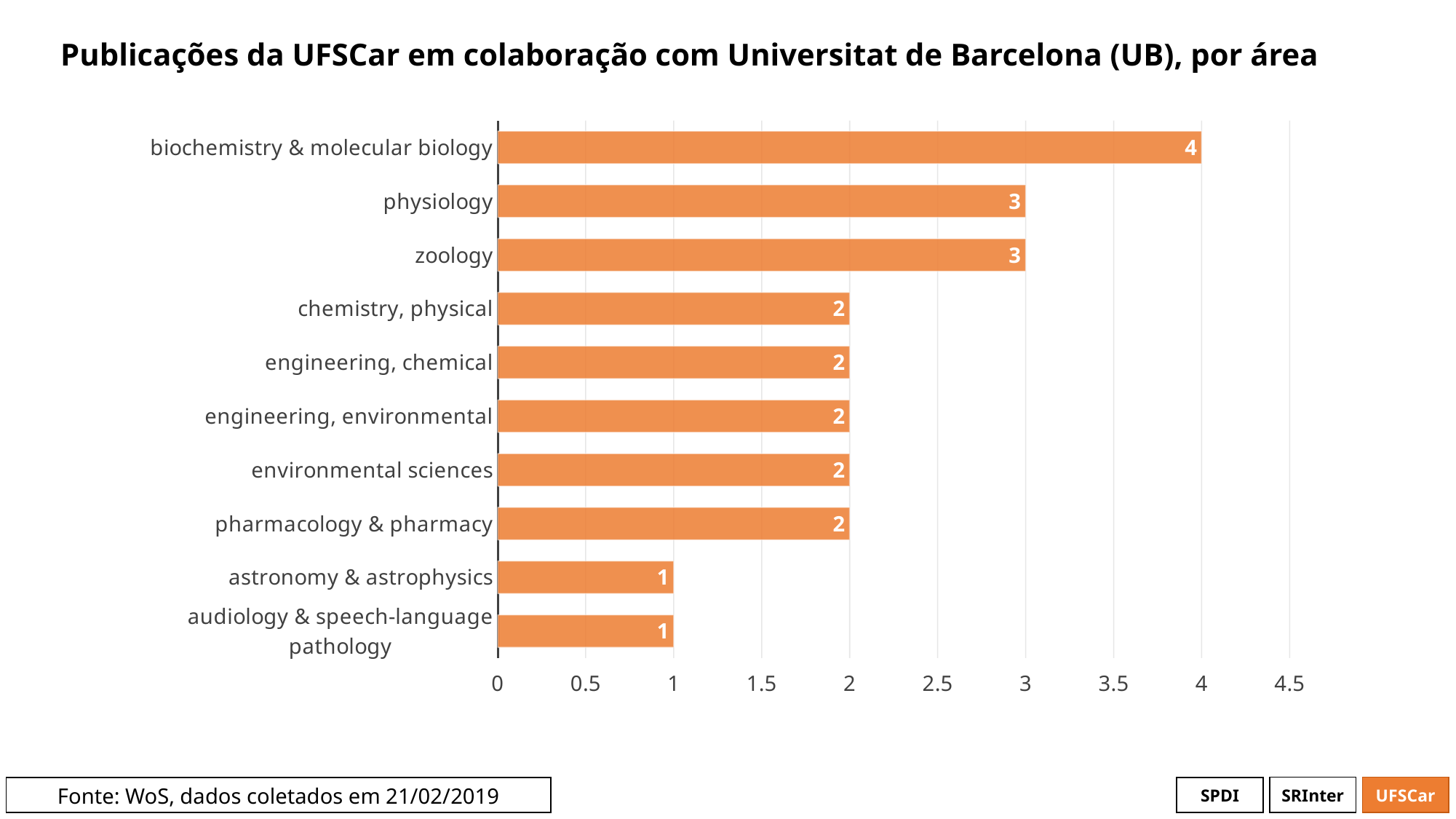
What is the title of the chart? Publicações da UFSCar em colaboração com Universitat de Barcelona (UB), por área What is the value for pharmacology & pharmacy? 2 What kind of chart is shown on the slide? bar chart What is the value for physiology? 3 What is the difference between the values for physiology and astronomy & astrophysics? 2 Is the value for engineering, chemical greater or less than 3? less What is the difference between the values for biochemistry & molecular biology and zoology? 1 Which category has the highest value? biochemistry & molecular biology What is the value for biochemistry & molecular biology? 4 How many categories are shown in the chart? 10 Which is larger, the value for zoology or the value for chemistry, physical? zoology What is the value for astronomy & astrophysics? 1